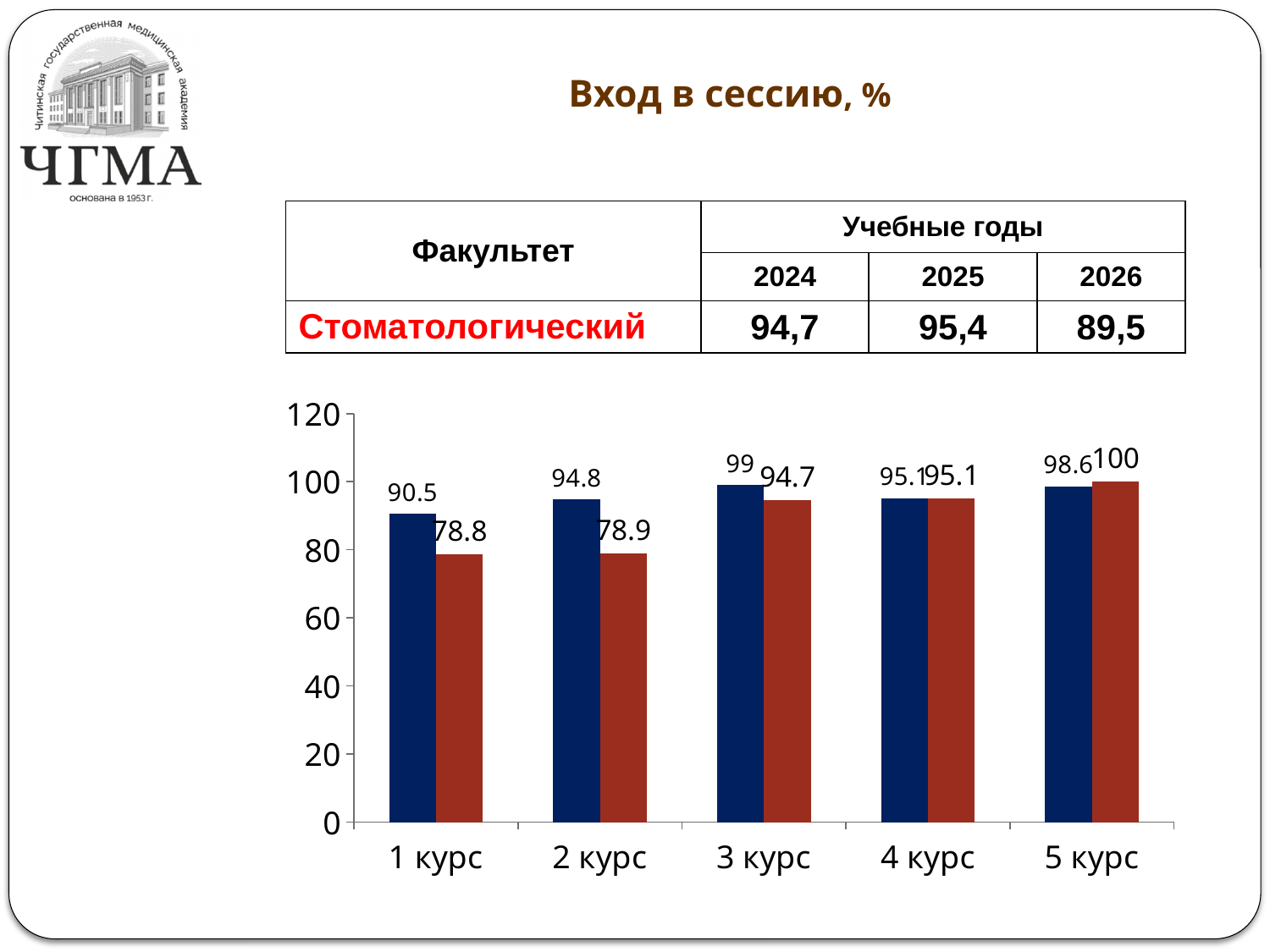
What is the difference between the dark blue and dark red bars for 1 курс? 11.7 What is the value of the dark red bar for 2 курс? 78.9 What is the value of the dark blue bar for 1 курс? 90.5 How many bar colours (series) are plotted for each category? 2 Which category has the lowest dark red bar? 1 курс Is the value of the dark red bar for 2 курс greater or less than 80? less What is the value of the dark red bar for 5 курс? 100 For 3 курс, which bar is larger, the dark blue or the dark red? dark blue How many categories are shown on the x axis? 5 What kind of chart is shown on the slide? bar chart Which category has the highest dark blue bar? 3 курс Do the dark red bars rise or fall from 1 курс to 5 курс? rise